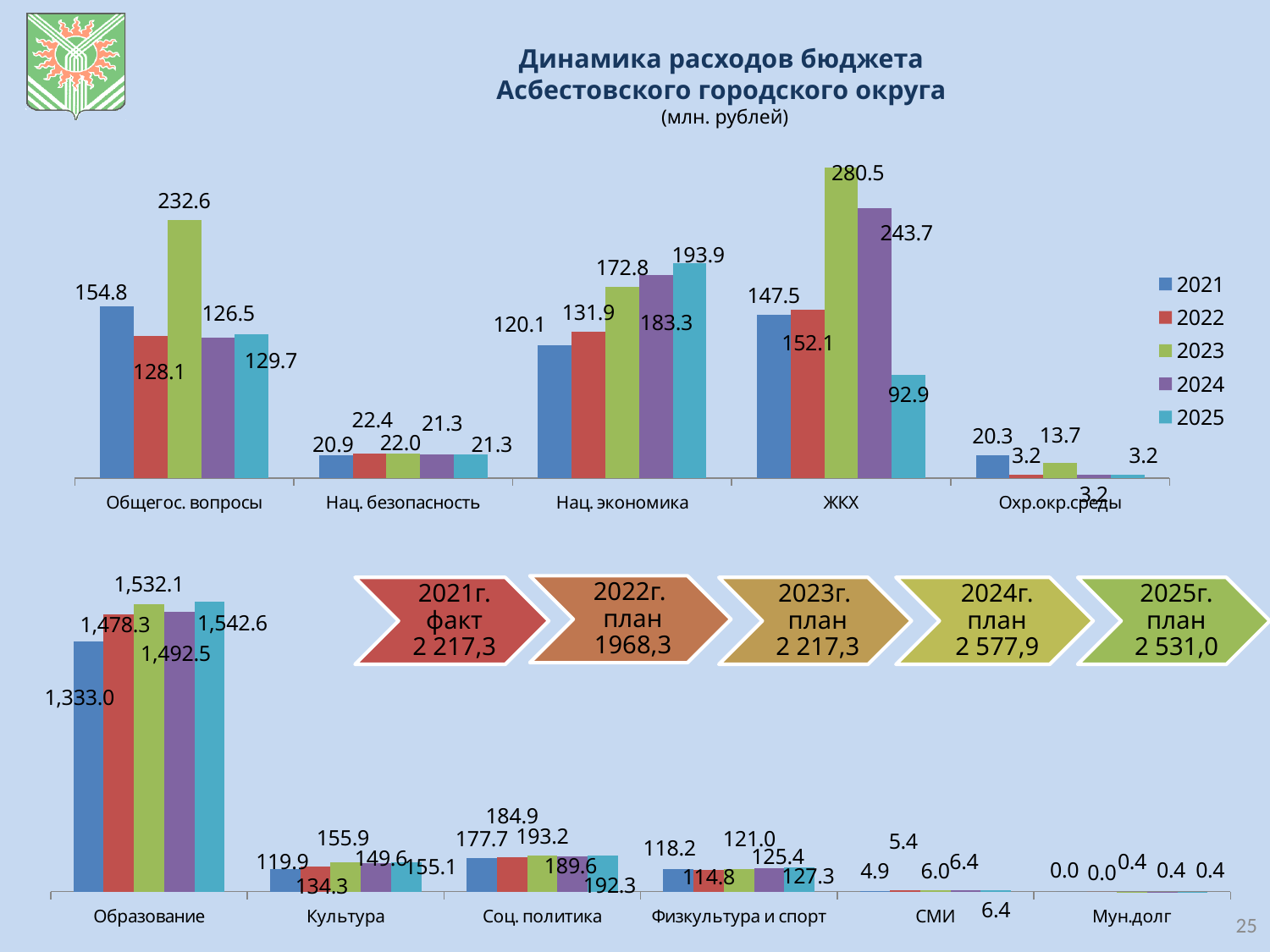
On the bottom chart, which is larger for Физкультура и спорт: the 2021 value or the 2025 value? 2025 What type of chart is the bottom chart? bar chart On the top chart, what is the value for ЖКХ in 2023? 280.5 How many series does the legend on the top chart list? 5 On the top chart, do the values for Нац. экономика rise or fall from 2021 to 2025? rise On the top chart, what is the value for Нац. экономика in 2025? 193.9 On the bottom chart, which year has the highest value for Культура? 2023 On the top chart, which year has the lowest value for ЖКХ? 2025 On the bottom chart, what is the value for Образование in 2021? 1,333.0 How many categories are shown on the bottom chart? 6 On the top chart, what is the difference between the 2023 and 2024 values for ЖКХ? 36.8 On the top chart, which year has the highest value for Общегос. вопросы? 2023